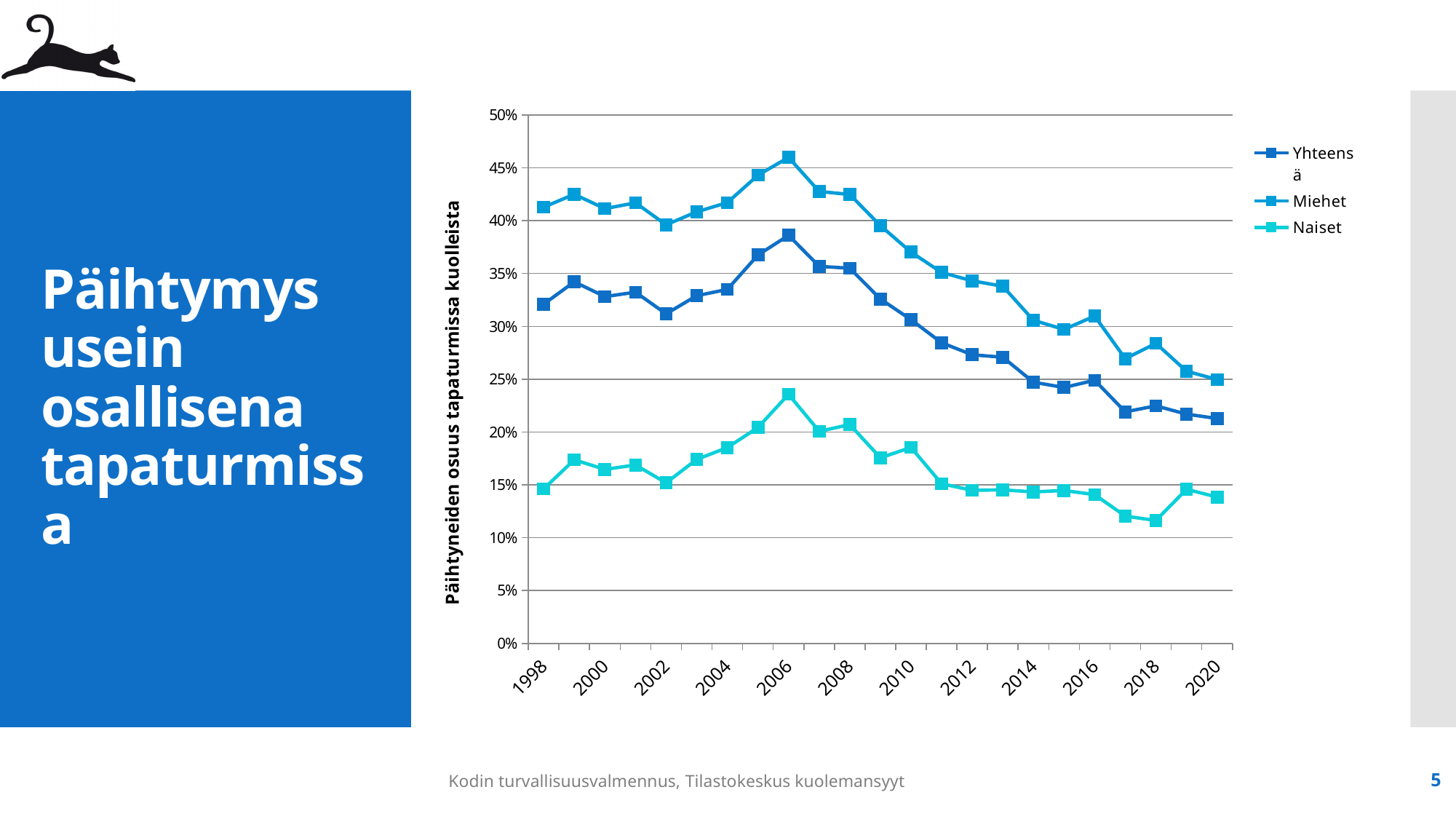
What kind of chart is shown on the slide? line chart How many series does the legend list? 3 In which year does the Miehet series reach its peak? 2006 What is the title of the vertical axis? Päihtyneiden osuus tapaturmissa kuolleista Which is larger in 2010, the value for Miehet or the value for Naiset? Miehet Is the value for Miehet in 2006 greater or less than 40%? greater Is the value for Naiset in 2018 greater or less than 15%? less Which series has the lowest values throughout the chart? Naiset Which series has the highest values throughout the chart? Miehet Do the values for Yhteensä rise or fall between 2006 and 2020? fall Is the value for Yhteensä in 2020 greater or less than 25%? less In which year does the Naiset series reach its peak? 2006